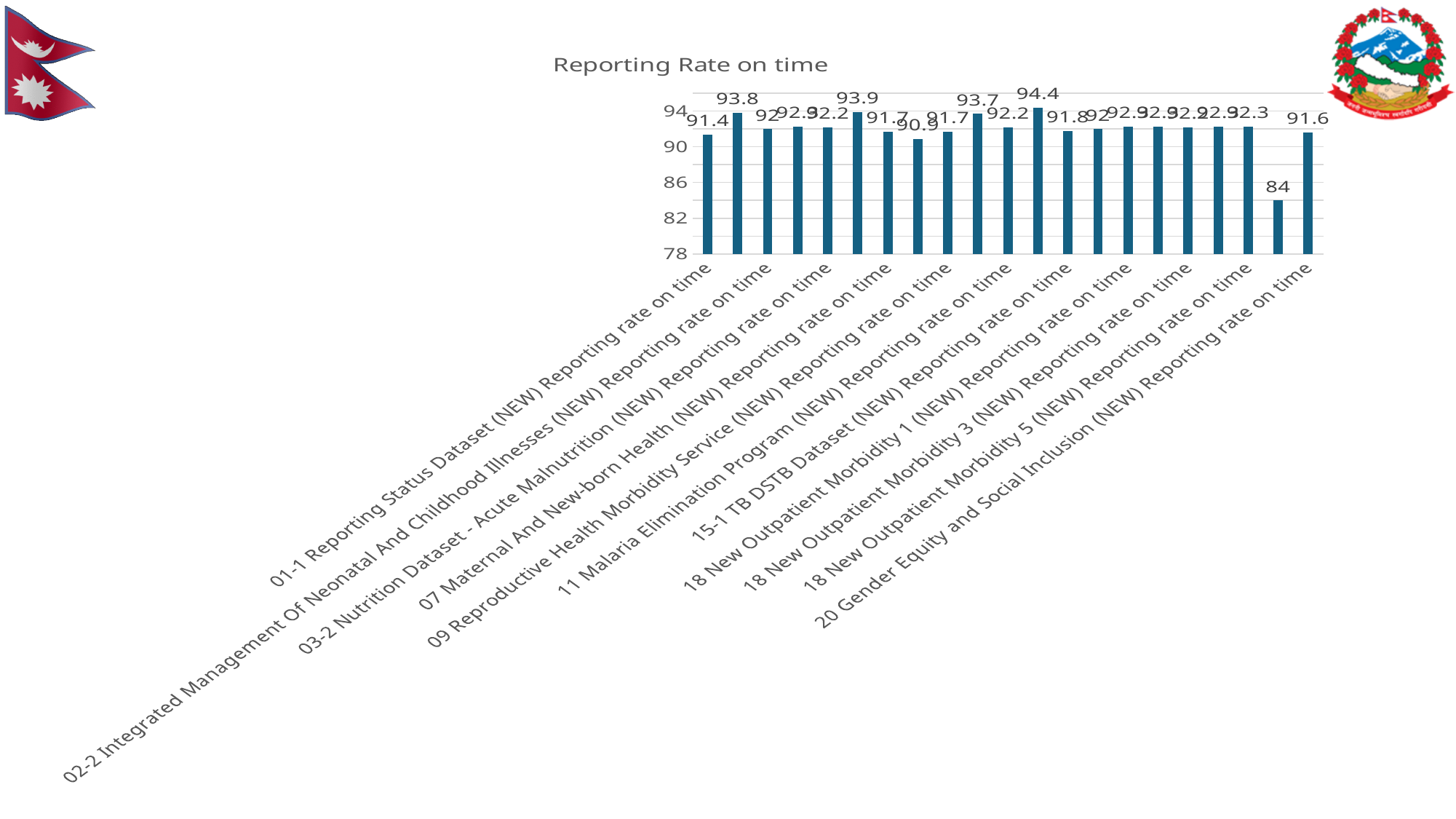
What is the lowest value shown in the chart? 84 What is the reporting rate on time for 20 Gender Equity and Social Inclusion (NEW)? 91.6 What is the highest value shown in the chart? 94.4 What is the difference between the highest and lowest values in the chart? 10.4 What is the title of the chart? Reporting Rate on time Is the lowest bar in the chart greater or less than 86? less What type of chart is shown on the slide? bar chart What is the difference between the values for 20 Gender Equity and Social Inclusion (NEW) and 01-1 Reporting Status Dataset (NEW)? 0.2 How many bars are plotted in the chart? 21 What is the lowest value shown on the vertical axis? 78 What is the reporting rate on time for 01-1 Reporting Status Dataset (NEW)? 91.4 Which has a higher reporting rate on time: 01-1 Reporting Status Dataset (NEW) or 20 Gender Equity and Social Inclusion (NEW)? 20 Gender Equity and Social Inclusion (NEW)